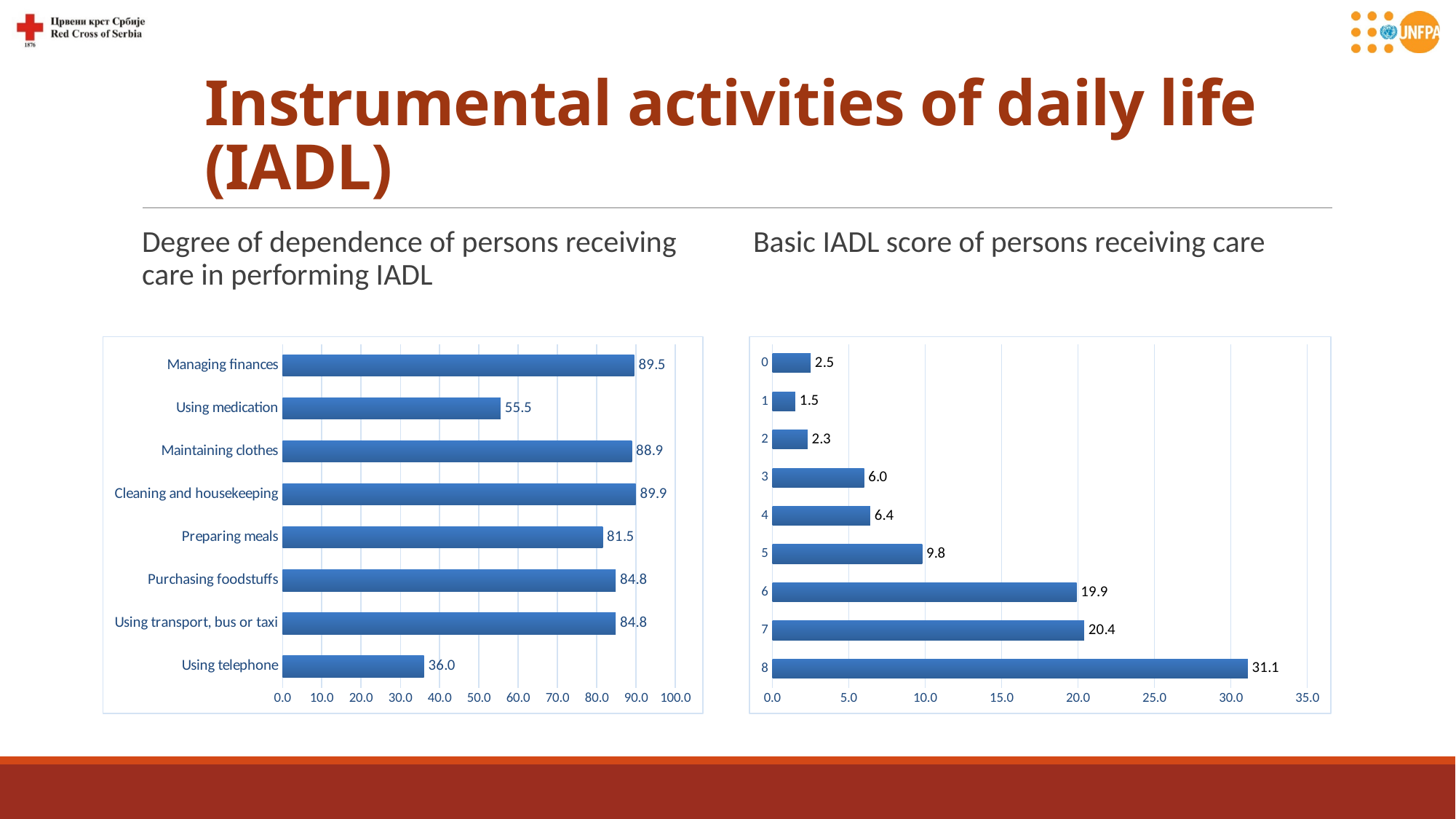
In the left chart (Degree of dependence in performing IADL), what is the difference between Managing finances and Using telephone? 53.5 In the left chart (Degree of dependence in performing IADL), what is the value for Using medication? 55.5 In the right chart (Basic IADL score), what is the difference between score 8 and score 7? 10.7 In the right chart (Basic IADL score), which score has the highest value? 8 In the left chart (Degree of dependence in performing IADL), what is the value for Cleaning and housekeeping? 89.9 In the left chart (Degree of dependence in performing IADL), which category has the lowest value? Using telephone In the right chart (Basic IADL score), which score has the lowest value? 1 In the left chart (Degree of dependence in performing IADL), which is larger: Preparing meals or Purchasing foodstuffs? Purchasing foodstuffs In the right chart (Basic IADL score), what is the value for score 6? 19.9 What type of chart is the right chart (Basic IADL score)? Bar chart In the left chart (Degree of dependence in performing IADL), how many categories are shown? 8 In the right chart (Basic IADL score), how many score categories are shown? 9